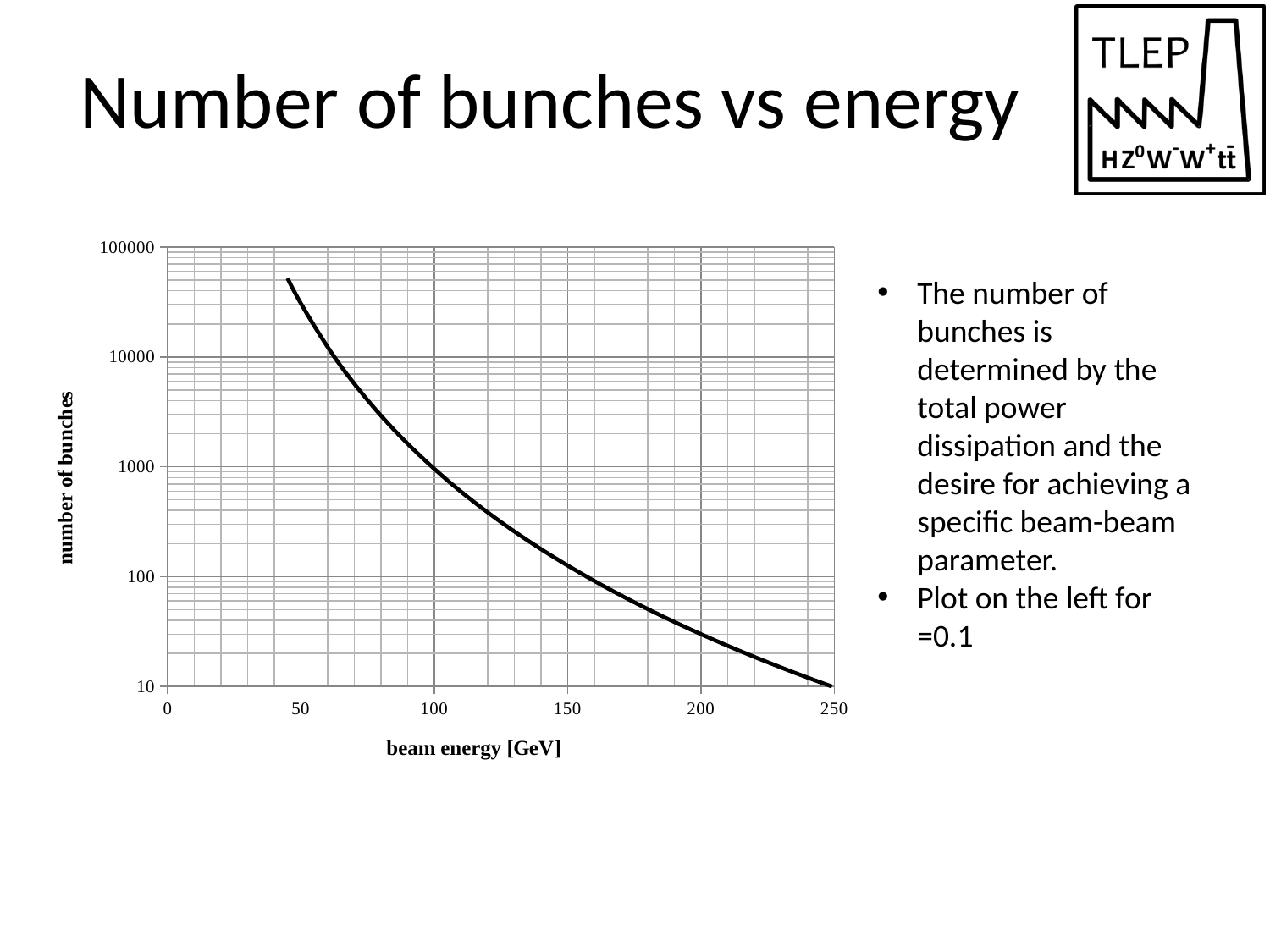
What is the label of the horizontal axis of the chart? beam energy [GeV] Is the number of bunches at a beam energy of 150 GeV greater or less than 1000? less What is the label of the vertical axis of the chart? number of bunches Is the number of bunches at a beam energy of 200 GeV greater or less than 100? less Is the number of bunches at a beam energy of 250 GeV greater or less than 100? less Which beam energy has the larger number of bunches, 50 GeV or 200 GeV? 50 GeV Does the number of bunches rise or fall as beam energy increases? fall What kind of chart is shown on the slide? line chart